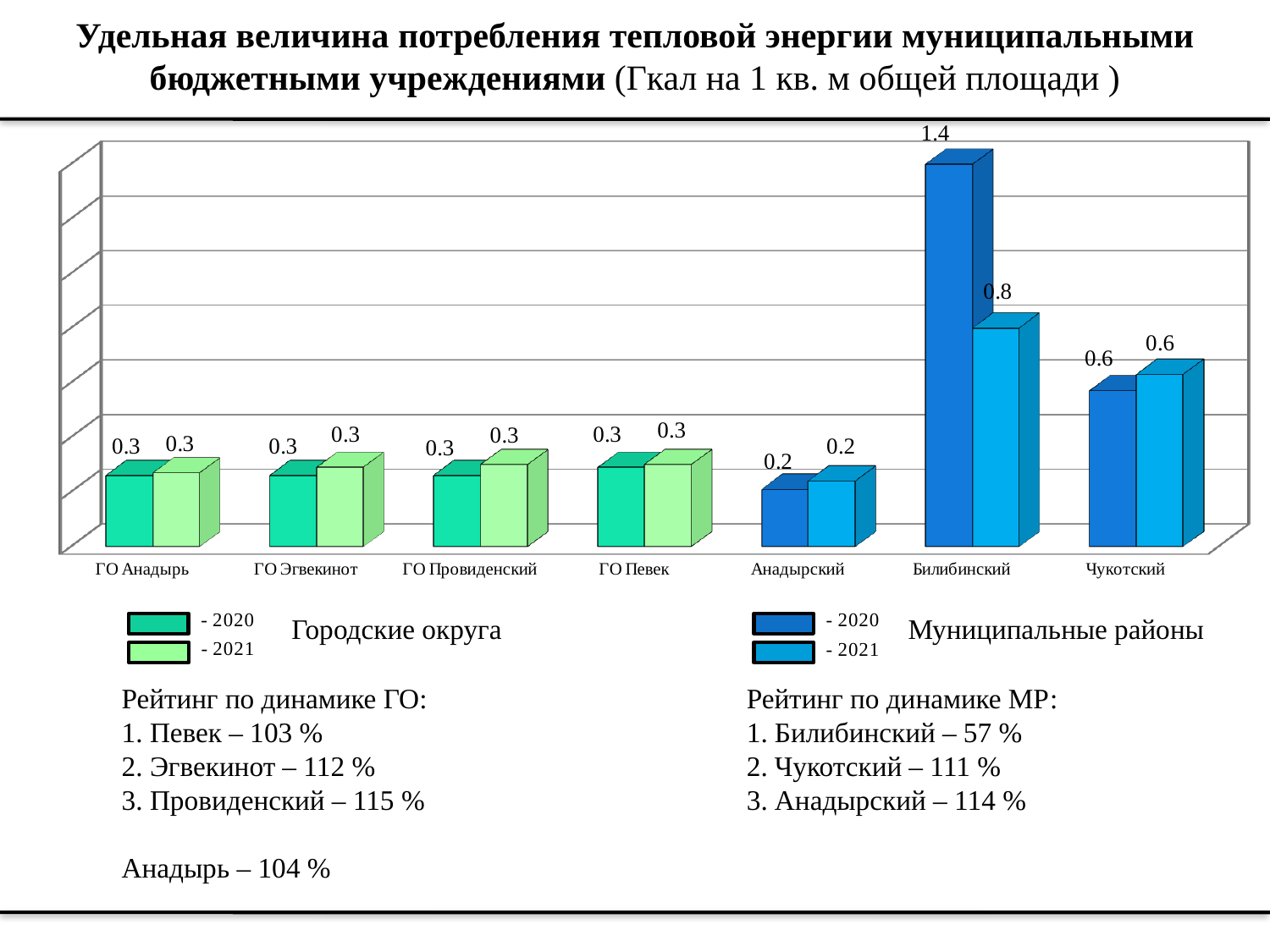
Which is larger: the 2021 value for Чукотский or the 2021 value for ГО Анадырь? Чукотский What is the 2020 value for Анадырский? 0.2 What is the 2021 value for Билибинский? 0.8 Which category has the lowest 2021 value? Анадырский What is the difference between the 2020 and 2021 values for Билибинский? 0.6 Which two years are listed in the chart legend? 2020 and 2021 Which category has the highest 2020 value? Билибинский What is the 2021 value for ГО Певек? 0.3 What is the 2020 value for Билибинский? 1.4 What kind of chart is shown on the slide? Bar chart What is the 2021 value for Чукотский? 0.6 How many categories are shown on the x axis of the chart? 7